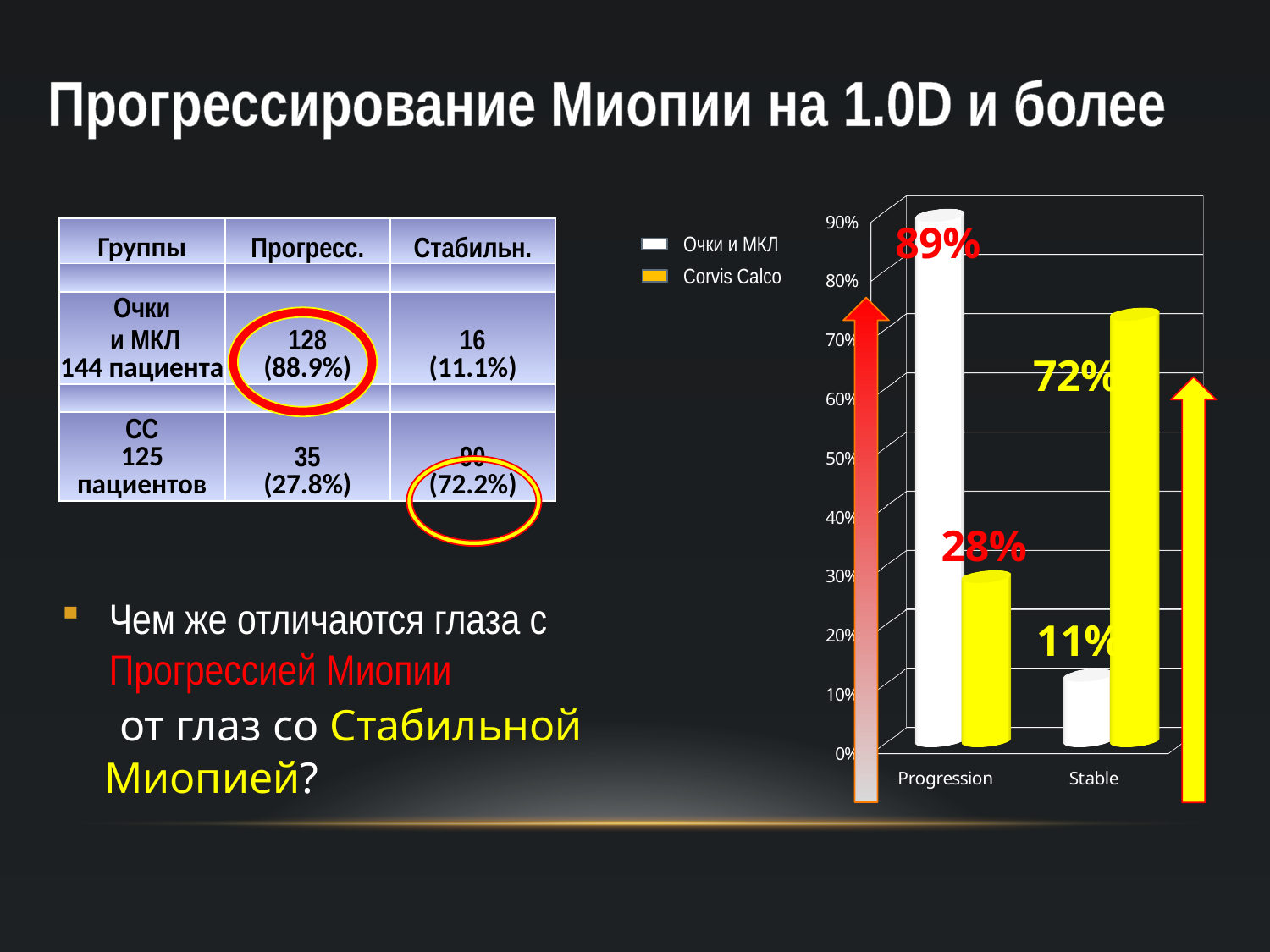
How many series does the chart legend list? 2 What is the difference between the Очки и МКЛ and Corvis Calco values in the Progression category? 61% What is the value for Corvis Calco in the Stable category? 72% What is the value for Corvis Calco in the Progression category? 28% Which series has the higher value in the Progression category? Очки и МКЛ What is the value for Очки и МКЛ in the Stable category? 11% How many categories are shown on the x axis of the chart? 2 Which colour represents the Corvis Calco series in the chart? yellow What is the value for Очки и МКЛ in the Progression category? 89% Which series has the higher value in the Stable category? Corvis Calco What kind of chart is shown on the slide? bar chart What is the difference between the Corvis Calco and Очки и МКЛ values in the Stable category? 61%